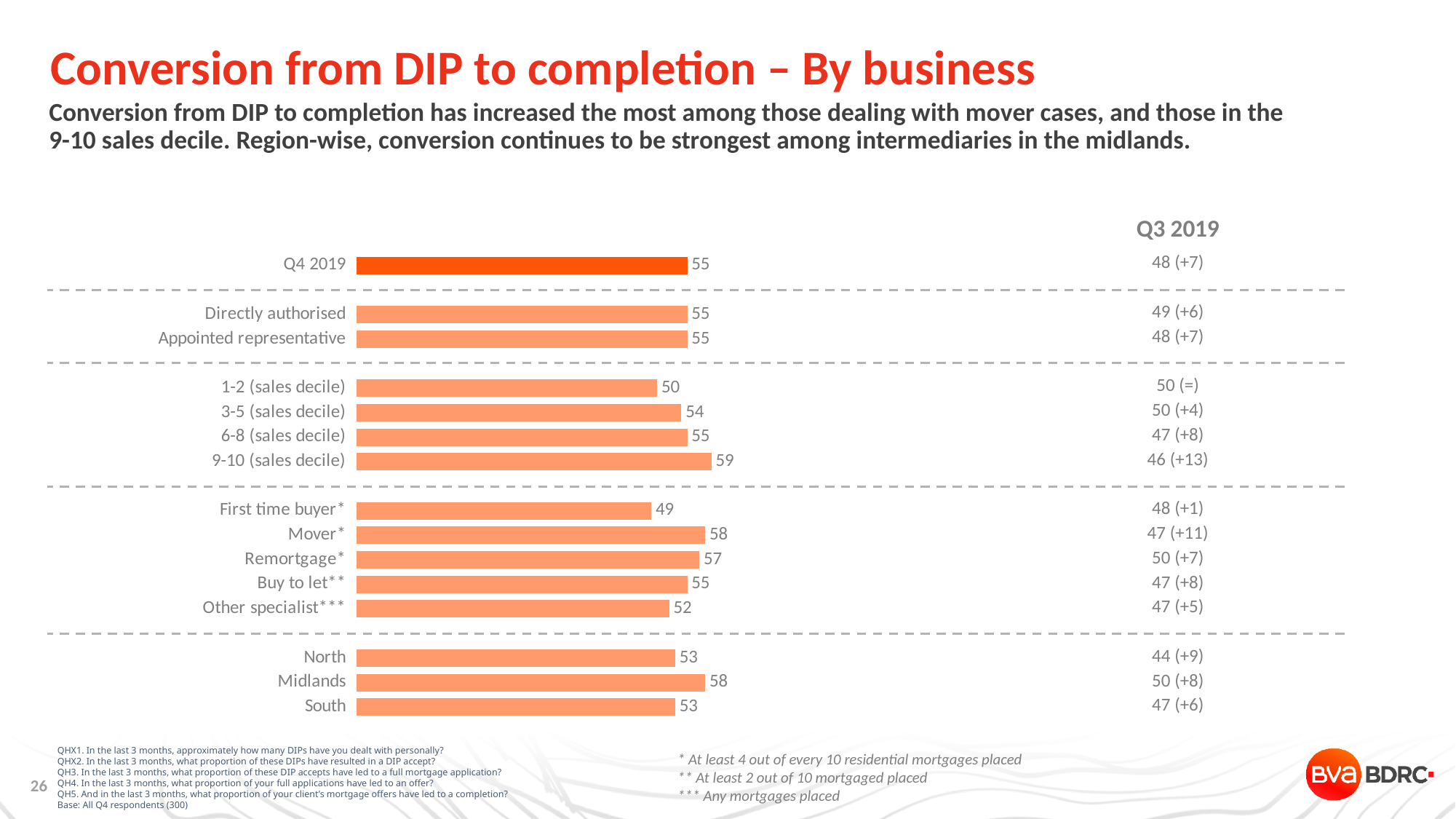
Which category has the highest value? 9-10 (sales decile) What is the value for 9-10 (sales decile)? 59 Which category has the lowest value? First time buyer How many bars are plotted in the chart? 15 Which is larger, the value for Midlands or the value for North? Midlands What is the difference between the values for 9-10 (sales decile) and 1-2 (sales decile)? 9 Which is larger, the value for Remortgage or the value for Buy to let? Remortgage What is the value for First time buyer? 49 What kind of chart is shown on the slide? Bar chart What is the value for Other specialist? 52 What is the difference between the values for Mover and First time buyer? 9 What is the value for Midlands? 58